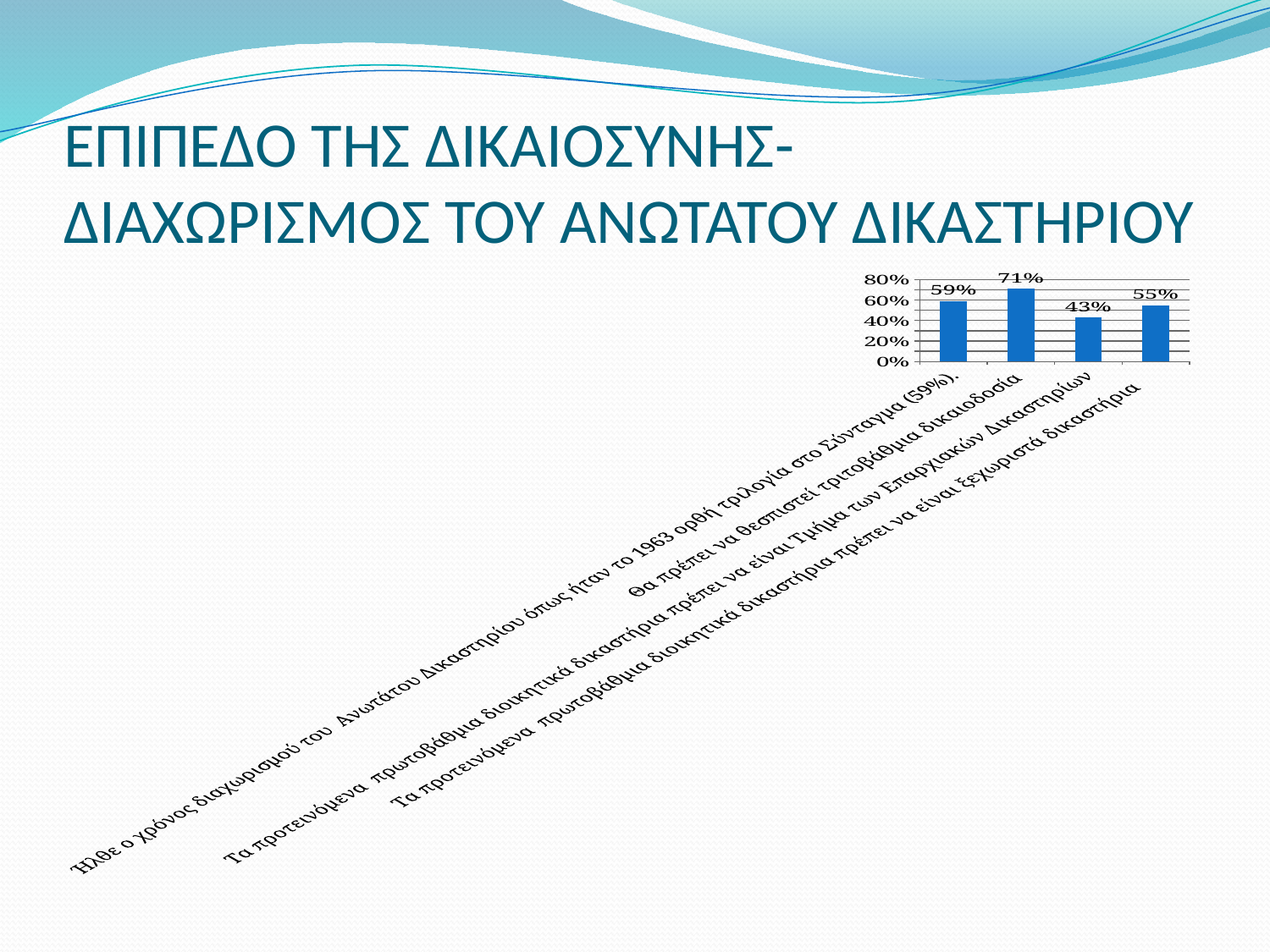
What is the value for the statement that the proposed first-instance administrative courts should be a section of the District Courts (Τμήμα των Επαρχιακών Δικαστηρίων)? 43% What is the difference between the value for the first bar (59%) and the value for the last bar (55%)? 4% Which statement has the highest value in the chart? Θα πρέπει να θεσπιστεί τριτοβάθμια δικαιοδοσία How many bars does the chart contain? 4 What is the value for the first bar, about the time having come to split the Supreme Court as it was in 1963? 59% Which statement has the lowest value in the chart? Τα προτεινόμενα πρωτοβάθμια διοικητικά δικαστήρια πρέπει να είναι Τμήμα των Επαρχιακών Δικαστηρίων What is the value for the statement that the proposed first-instance administrative courts should be separate courts (ξεχωριστά δικαστήρια)? 55% Which is larger: the value for the first bar (split of the Supreme Court as in 1963) or the value for the last bar (separate courts)? the first bar (59%) What type of chart is shown on the slide? bar chart What is the highest value shown on the vertical axis of the chart? 80% What is the value for the statement that a third-tier jurisdiction should be established (Θα πρέπει να θεσπιστεί τριτοβάθμια δικαιοδοσία)? 71% What is the difference between the highest value (71%) and the lowest value (43%) in the chart? 28%